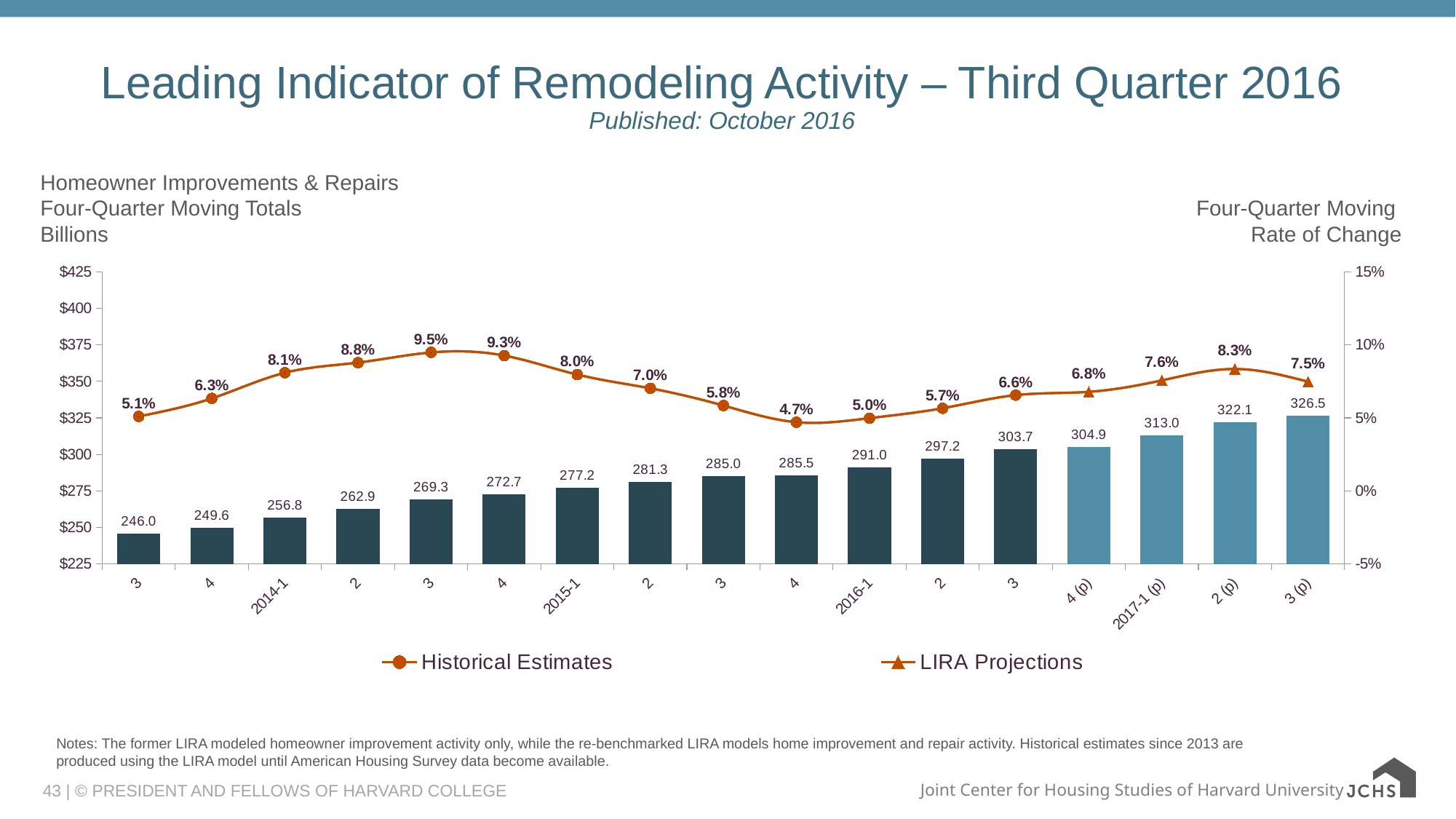
How many series does the legend list? 2 Is the four-quarter moving total for 2015-1 greater or less than $275? greater What is the rate of change shown for 2017-1 (p)? 7.6% What is the four-quarter moving total (in billions) for 2016-1? 291.0 Which period has the lowest four-quarter moving rate of change? 2015-4 (4.7%) Do the four-quarter moving totals rise or fall from left to right across the chart? rise How many bars are plotted in the chart? 17 Which is larger, the rate of change for 2015-1 or for 2 (p)? 2 (p) What is the difference in four-quarter moving totals between 2017-1 (p) and 2016-1? 22.0 Which period has the highest four-quarter moving rate of change? 2014-3 (9.5%) What is the projected four-quarter moving total for 3 (p)? 326.5 What is the four-quarter moving rate of change for 2014-1? 8.1%